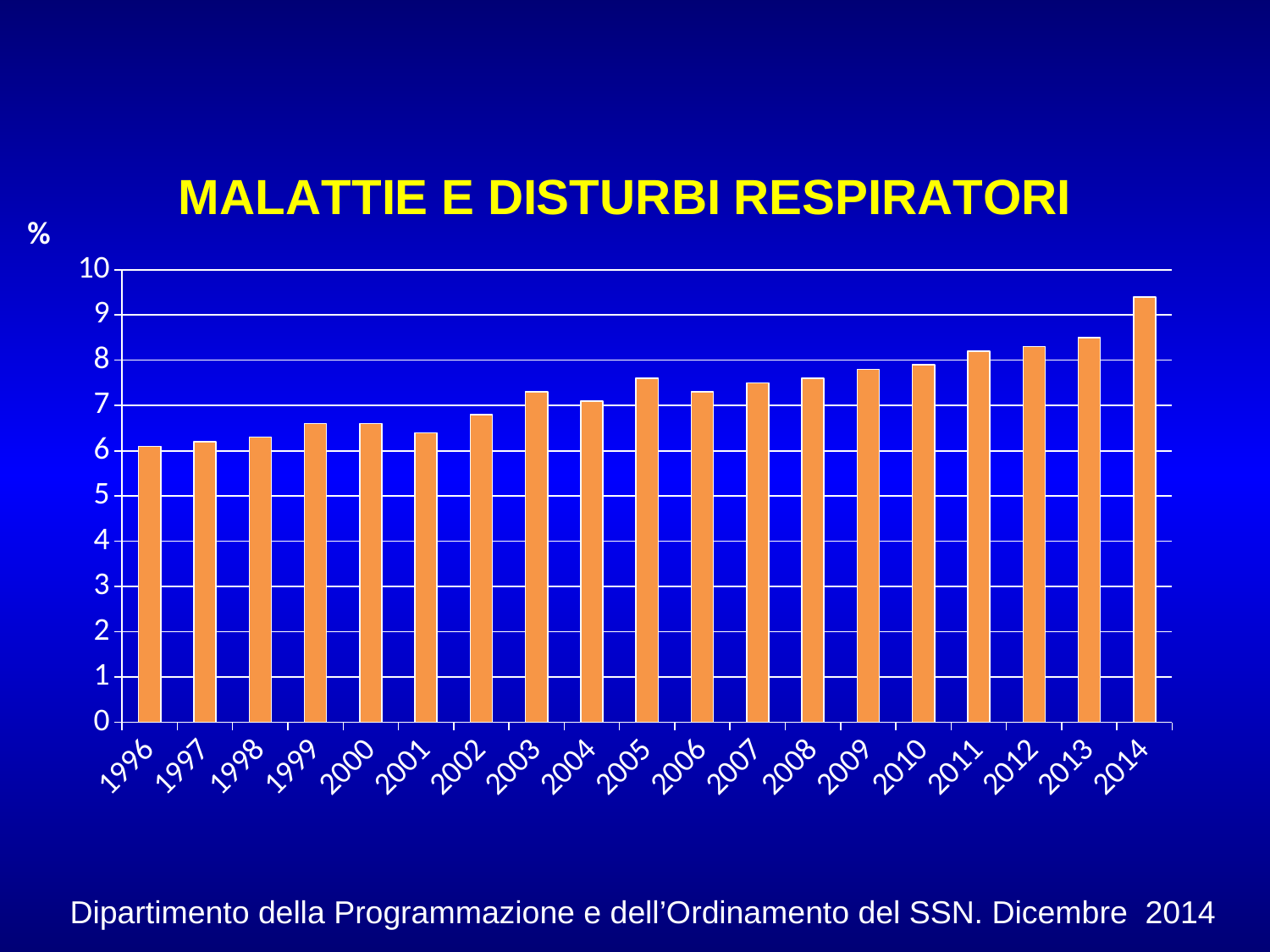
What is the title of the chart? MALATTIE E DISTURBI RESPIRATORI Is the value for 2011 greater or less than 8? greater How many years are plotted on the x axis of the chart? 19 Is the value for 2003 greater or less than 7? greater Is the value for 2001 greater or less than 7? less What unit is shown on the y axis of the chart? % What kind of chart is shown on the slide? bar chart Which year has the highest value in the chart? 2014 Which is larger, the value for 2013 or the value for 2010? 2013 Do the values generally rise or fall from 1996 to 2014? rise